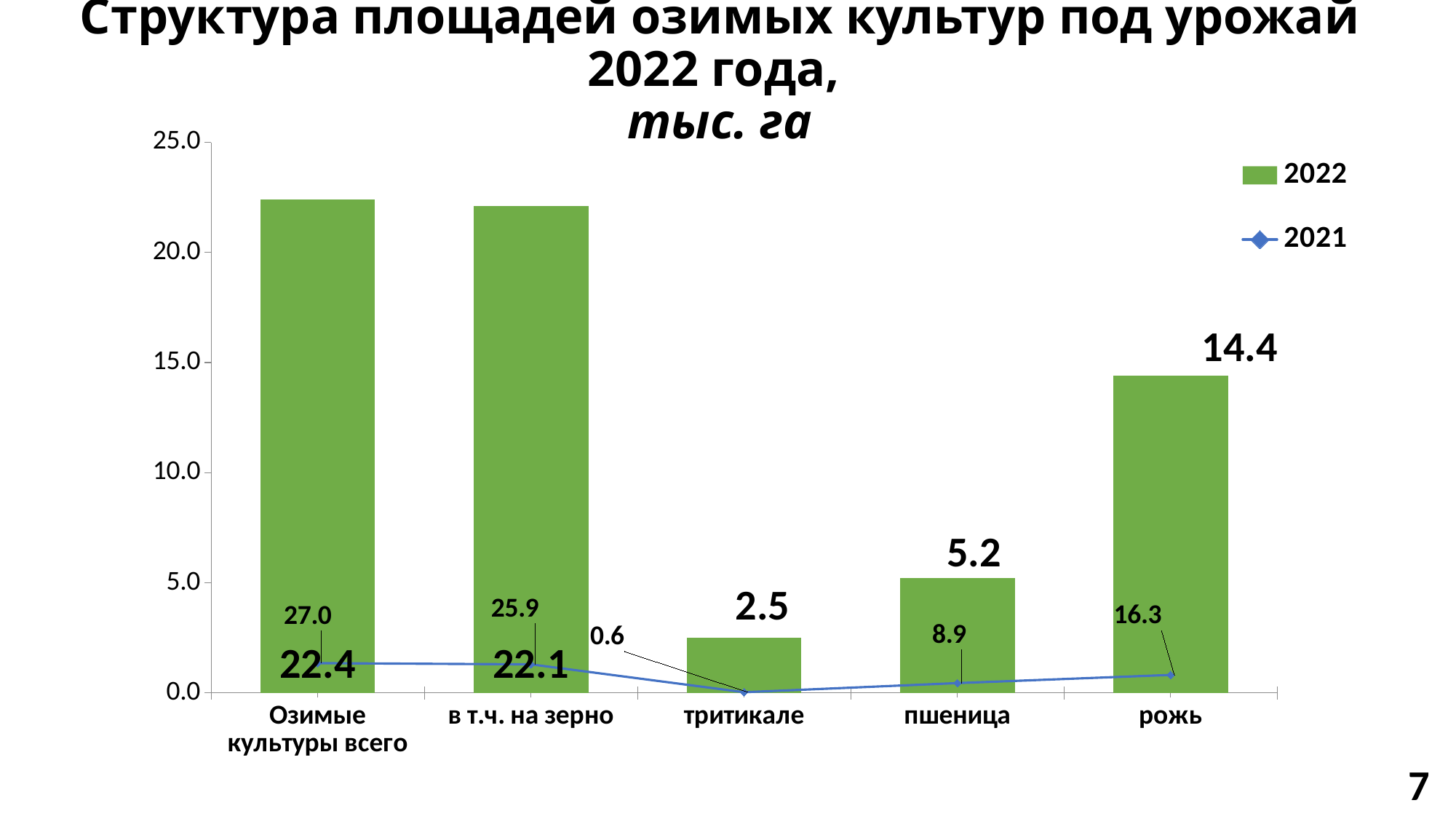
What is the difference between the 2021 and 2022 values for в т.ч. на зерно? 3.8 What is the 2022 value for рожь? 14.4 What is the 2021 value for Озимые культуры всего? 27.0 How many series does the legend list? 2 What is the 2021 value for пшеница? 8.9 Which category has the highest 2022 value? Озимые культуры всего What is the difference between the 2022 values for рожь and пшеница? 9.2 What is the 2022 value for тритикале? 2.5 Which category has the lowest 2022 value? тритикале Which is larger for рожь: the 2021 value or the 2022 value? 2021 What colour are the 2022 bars? green How many categories are shown on the x axis? 5